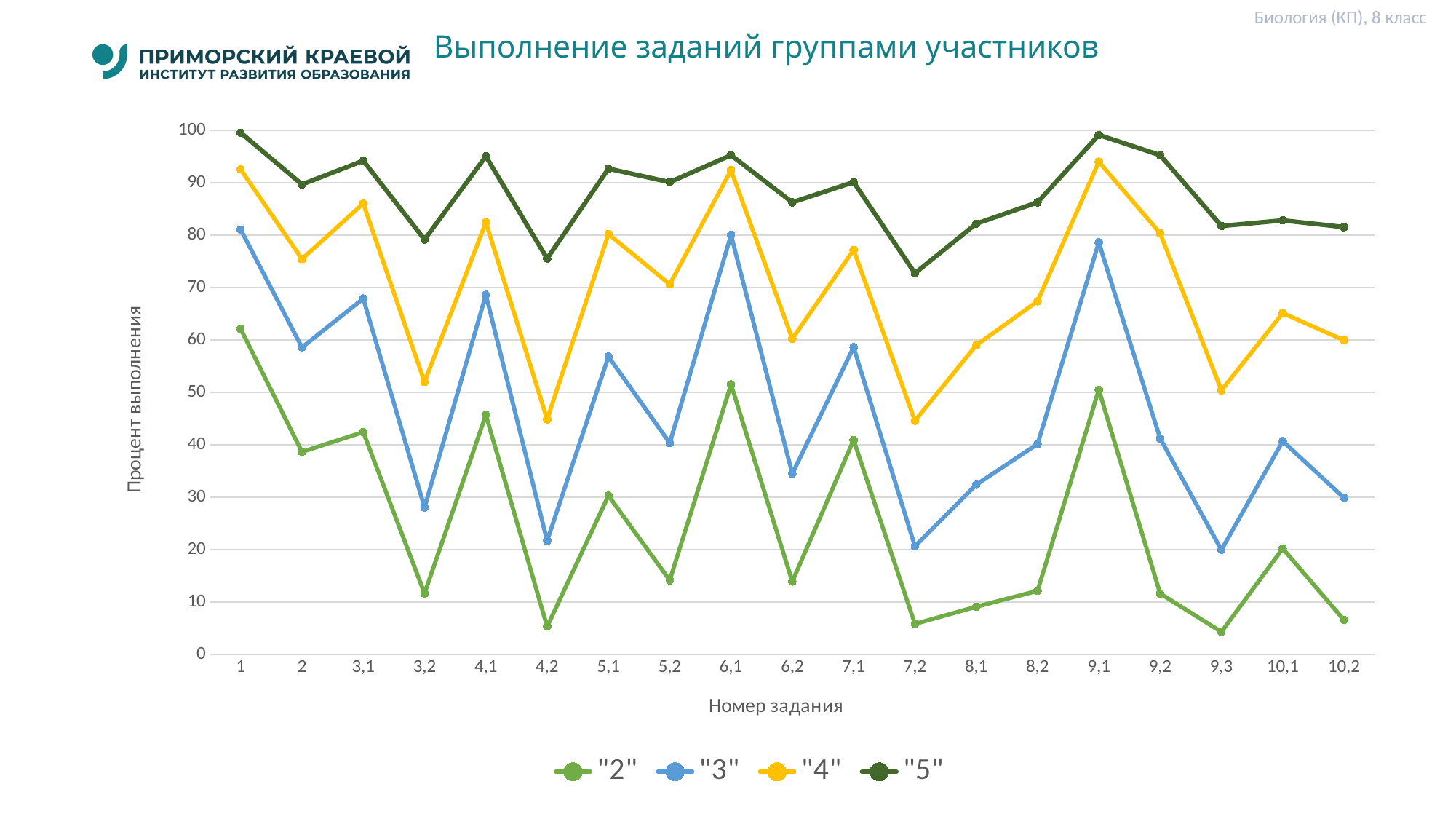
For series "2", at which task number is the value highest? 1 Is the value for series "4" at task 4,2 greater or less than 50? less Is the value for series "5" at task 7,2 greater or less than 70? greater For series "2", do the values rise or fall from task 7,2 to task 9,1? rise How many series does the legend list? 4 Is the value for series "5" at task 1 greater or less than 90? greater What is the title of the vertical axis? Процент выполнения For series "3", which is larger: the value at task 3,1 or at task 5,1? 3,1 What kind of chart is shown on the slide? line chart How many task numbers are shown along the x axis? 19